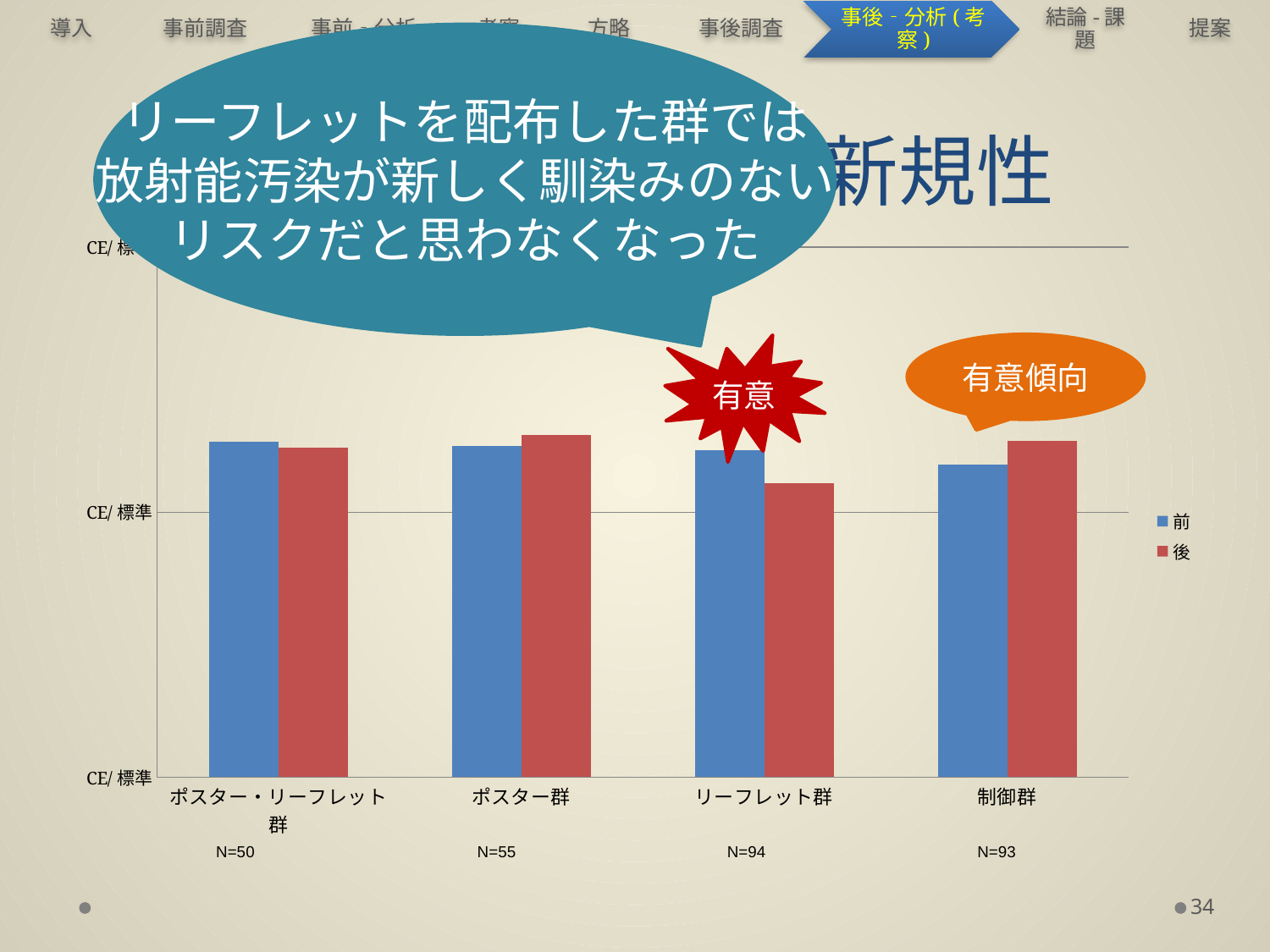
For リーフレット群, which is larger, the 前 bar or the 後 bar? 前 What kind of chart is shown on the slide? bar chart How many series does the chart's legend list? 2 What is the sample size (N) shown for 制御群? N=93 What are the two series listed in the chart's legend? 前 and 後 Which colour represents the 後 series in the chart? red For 制御群, which is larger, the 前 bar or the 後 bar? 後 For ポスター群, which is larger, the 前 bar or the 後 bar? 後 Which category has the lowest 後 value? リーフレット群 What is the sample size (N) shown for リーフレット群? N=94 How many categories (groups) are shown on the x axis of the chart? 4 What is the sample size (N) shown for ポスター・リーフレット群? N=50